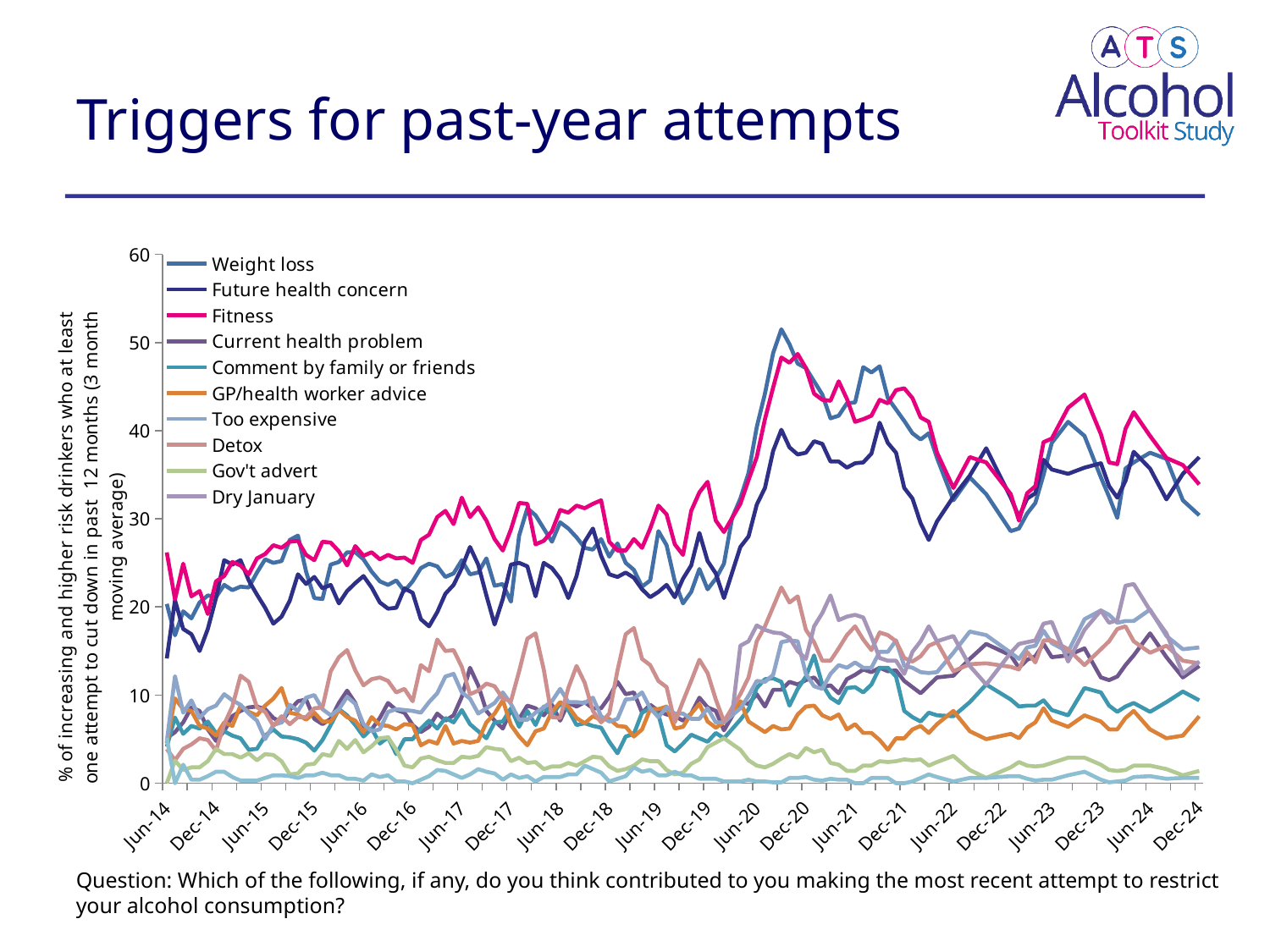
Does the Weight loss series rise or fall between Jun-14 and Dec-20? Rise How many series does the legend list? 10 What is the highest value shown on the y axis? 60 At Dec-24, which is larger: Dry January or Gov't advert? Dry January Which series reaches the highest value anywhere on the chart? Weight loss Is the value for Too expensive at Dec-24 greater or less than 10? greater What is the title of the slide's chart? Triggers for past-year attempts Is the value for Weight loss around Dec-20 greater or less than 40? greater Is the value for Fitness at Dec-24 greater or less than 30? greater What kind of chart is shown on the slide? Line chart